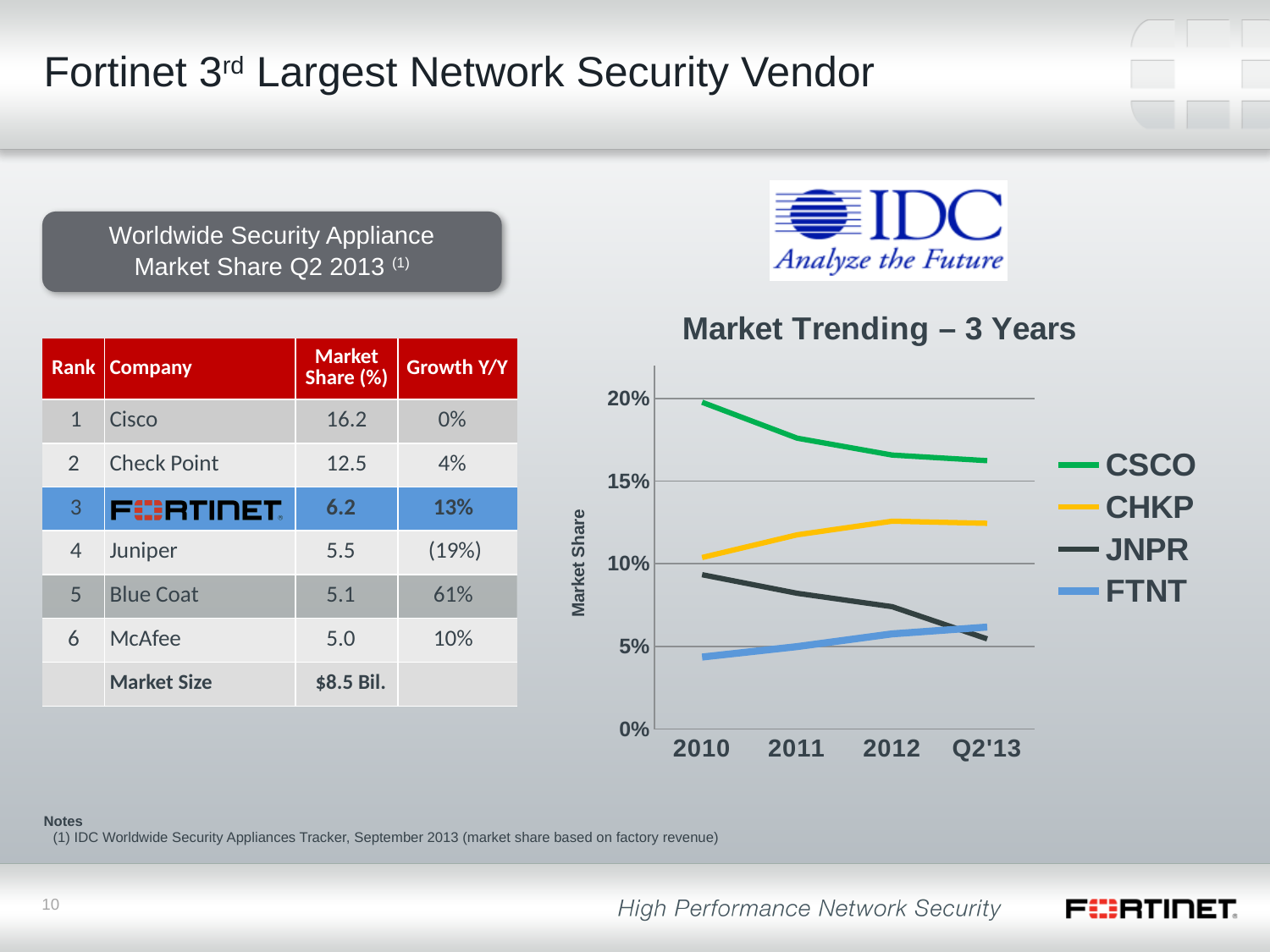
In the "Market Trending – 3 Years" chart, does the CSCO line rise or fall from 2010 to Q2'13? fall In the "Market Trending – 3 Years" chart, is the value for CSCO in 2010 greater or less than 15%? greater How many series does the legend of the "Market Trending – 3 Years" chart list? 4 What is the label on the y axis of the "Market Trending – 3 Years" chart? Market Share In the "Market Trending – 3 Years" chart, does the FTNT line rise or fall from 2010 to Q2'13? rise In the "Market Trending – 3 Years" chart, is the value for CHKP in 2012 greater or less than 10%? greater In the "Market Trending – 3 Years" chart, which series has the highest market share in 2010? CSCO In the "Market Trending – 3 Years" chart, is the value for JNPR at Q2'13 greater or less than 10%? less In the "Market Trending – 3 Years" chart, which series has the lowest market share in 2010? FTNT In the "Market Trending – 3 Years" chart, does the JNPR line rise or fall from 2010 to Q2'13? fall What kind of chart is the "Market Trending – 3 Years" chart? line chart How many points are shown along the x axis of the "Market Trending – 3 Years" chart? 4